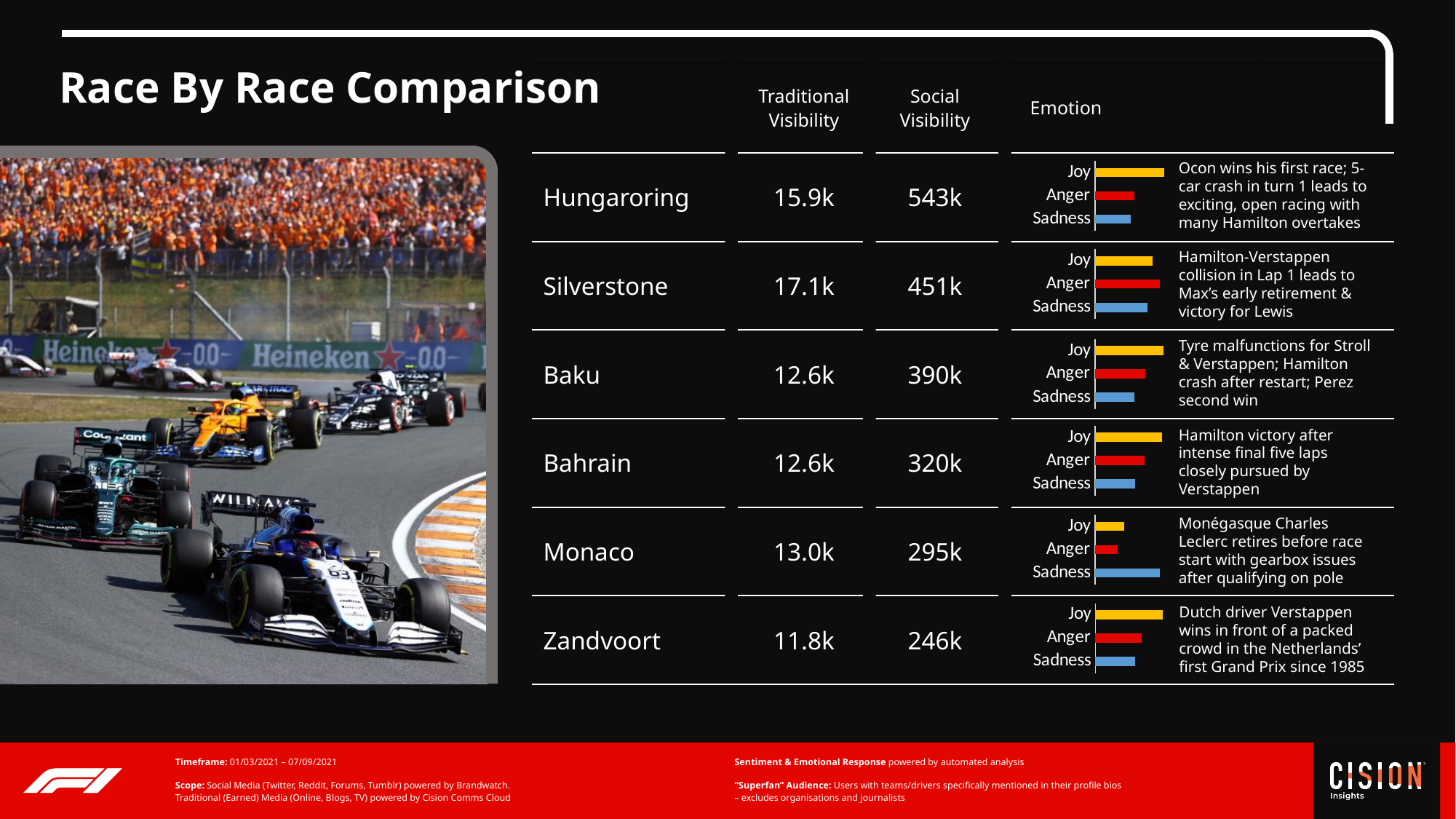
In the Monaco Emotion chart, which emotion has the longest bar? Sadness In the Monaco Emotion chart, which emotion has the shortest bar? Anger How many races have an Emotion bar chart on the slide? 6 What colour are the Joy bars in the Emotion charts? yellow In the Bahrain Emotion chart, which emotion has the longest bar? Joy In the Hungaroring Emotion chart, which bar is longer, Joy or Sadness? Joy What kind of chart is used in the Emotion column for each race? bar chart In the Hungaroring Emotion chart, which emotion has the longest bar? Joy In the Monaco Emotion chart, which bar is longer, Sadness or Anger? Sadness How many emotion categories are plotted in each race's Emotion chart? 3